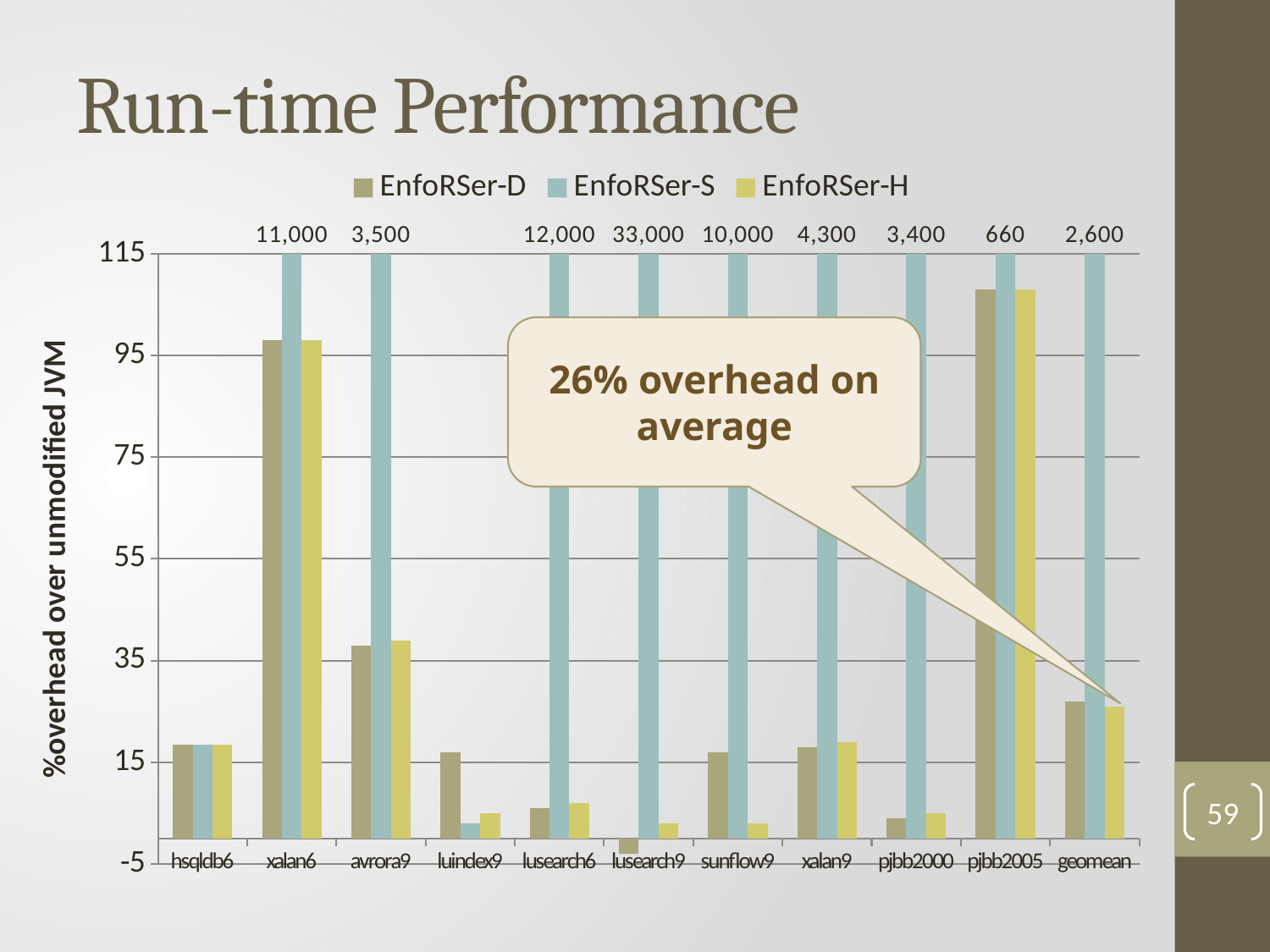
What is the label printed above the EnfoRSer-S bar for pjbb2005? 660 Which is larger, the EnfoRSer-D value for xalan6 or the EnfoRSer-D value for avrora9? xalan6 Is the EnfoRSer-D value for xalan6 greater or less than 95? greater Which category has the lowest EnfoRSer-D bar? lusearch9 How many benchmark categories are shown along the x axis? 11 How many series does the legend list? 3 Which category has the highest EnfoRSer-D bar? pjbb2005 What kind of chart is shown on the slide? bar chart Is the EnfoRSer-H value for luindex9 greater or less than 15? less What is the label printed above the EnfoRSer-S bar for lusearch9? 33,000 Which category has the largest EnfoRSer-S value? lusearch9 What is the title of the y axis? %overhead over unmodified JVM